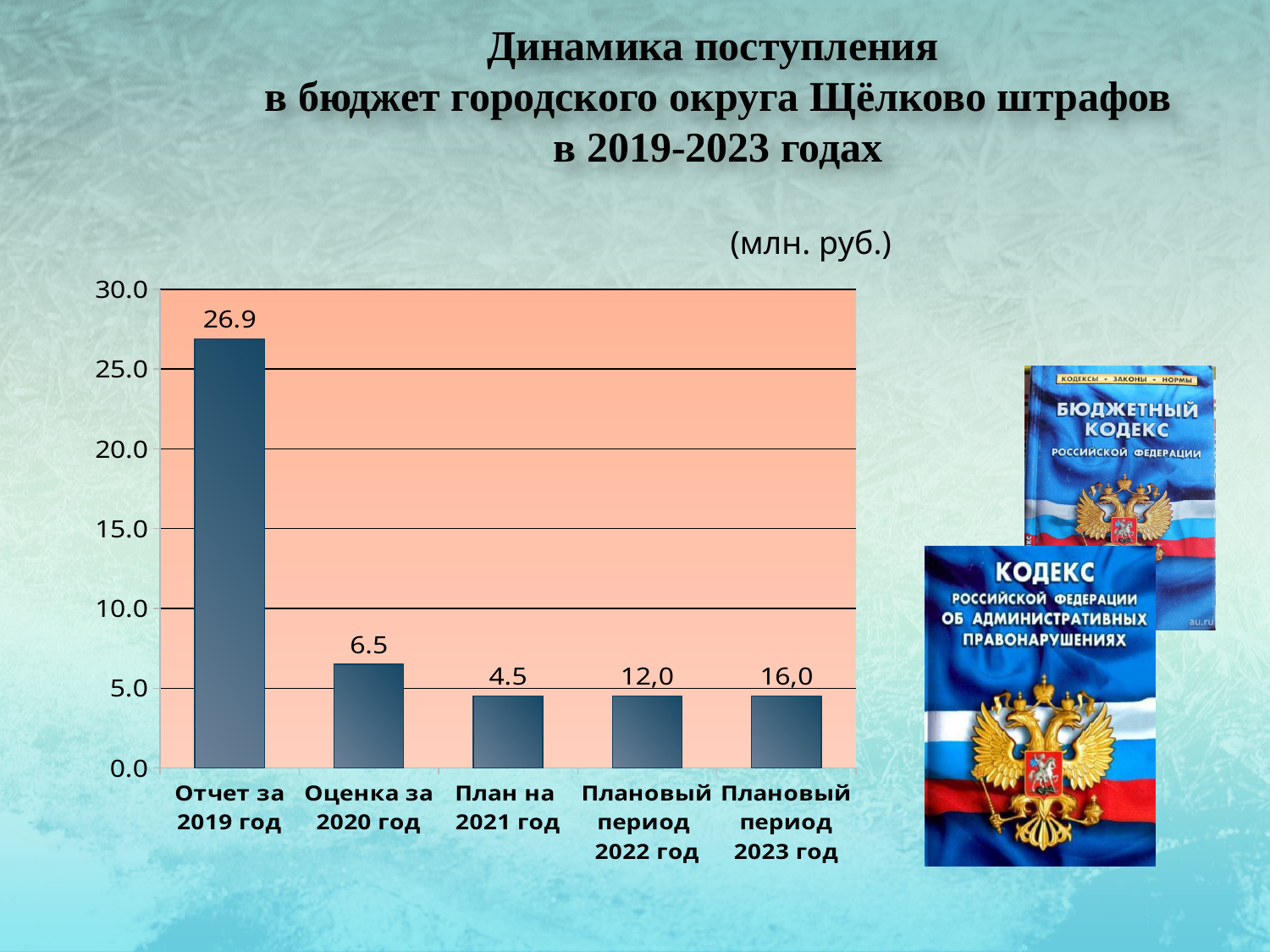
What data label is printed above the bar for "Плановый период 2023 год"? 16,0 Is the value for "Отчет за 2019 год" greater or less than 25.0? greater What value is shown for "Оценка за 2020 год"? 6.5 What value is shown for "Отчет за 2019 год"? 26.9 What is the difference between the values for "Отчет за 2019 год" and "Оценка за 2020 год"? 20.4 In what units are the chart values given, according to the label above the chart? млн. руб. Which category has the highest value? Отчет за 2019 год What kind of chart is shown on the slide? bar chart What value is shown for "План на 2021 год"? 4.5 Which is larger: the value for "Оценка за 2020 год" or for "План на 2021 год"? Оценка за 2020 год How many categories are shown on the x axis? 5 Do the values rise or fall from "Отчет за 2019 год" to "План на 2021 год"? fall